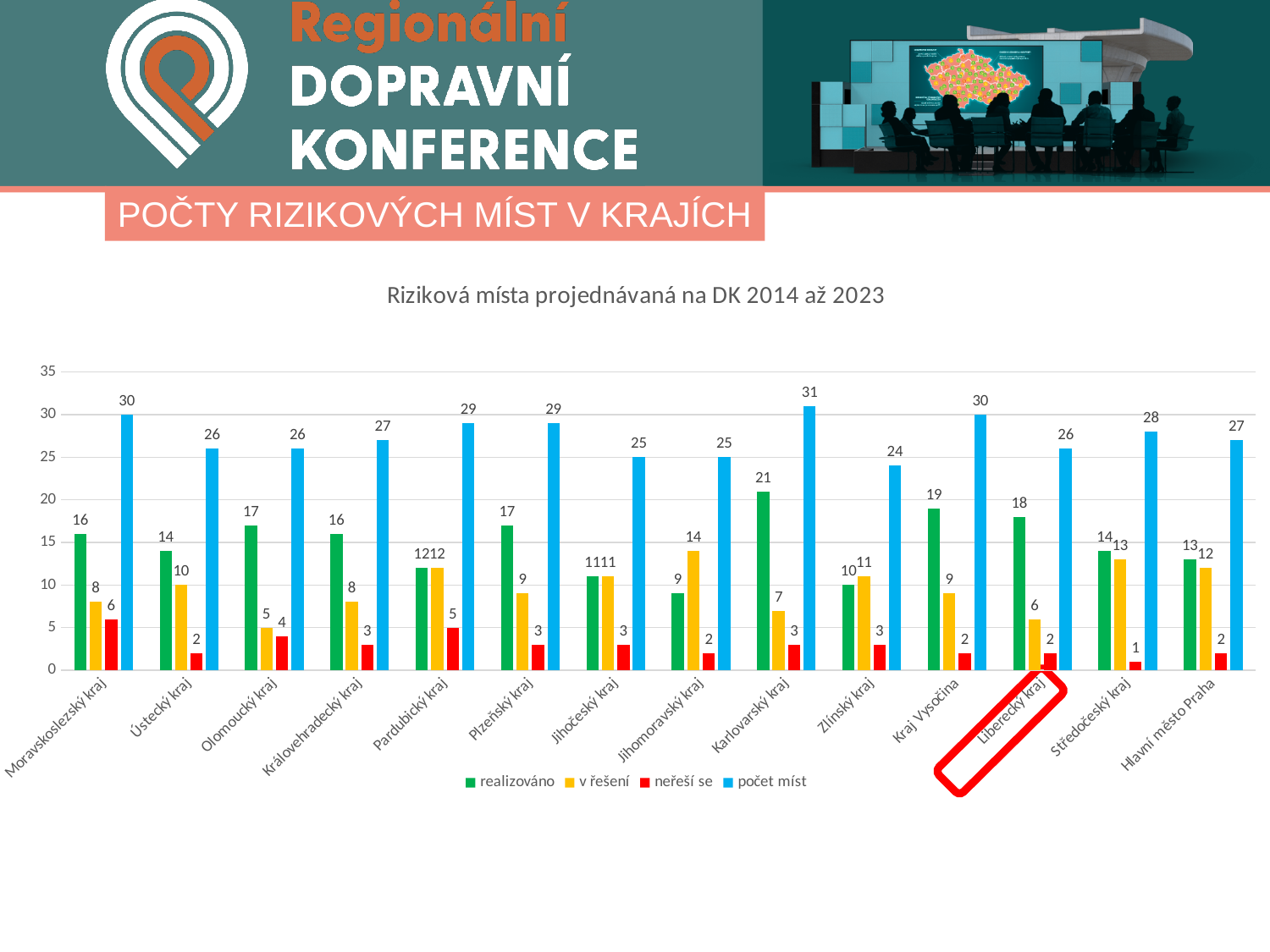
How many regions are shown on the x axis? 14 What type of chart is shown on the slide? Bar chart What is the value of 'počet míst' for Karlovarský kraj? 31 Which region has the lowest 'počet míst' value? Zlínský kraj Which region has the highest 'počet míst' value? Karlovarský kraj Which region has the lowest 'neřeší se' value? Středočeský kraj What is the 'neřeší se' value for Moravskoslezský kraj? 6 What is the 'realizováno' value for Liberecký kraj? 18 What is the difference between 'počet míst' and 'realizováno' for Kraj Vysočina? 11 Which is larger for Olomoucký kraj: 'realizováno' or 'v řešení'? realizováno What is the 'v řešení' value for Jihomoravský kraj? 14 How many series does the legend list? 4